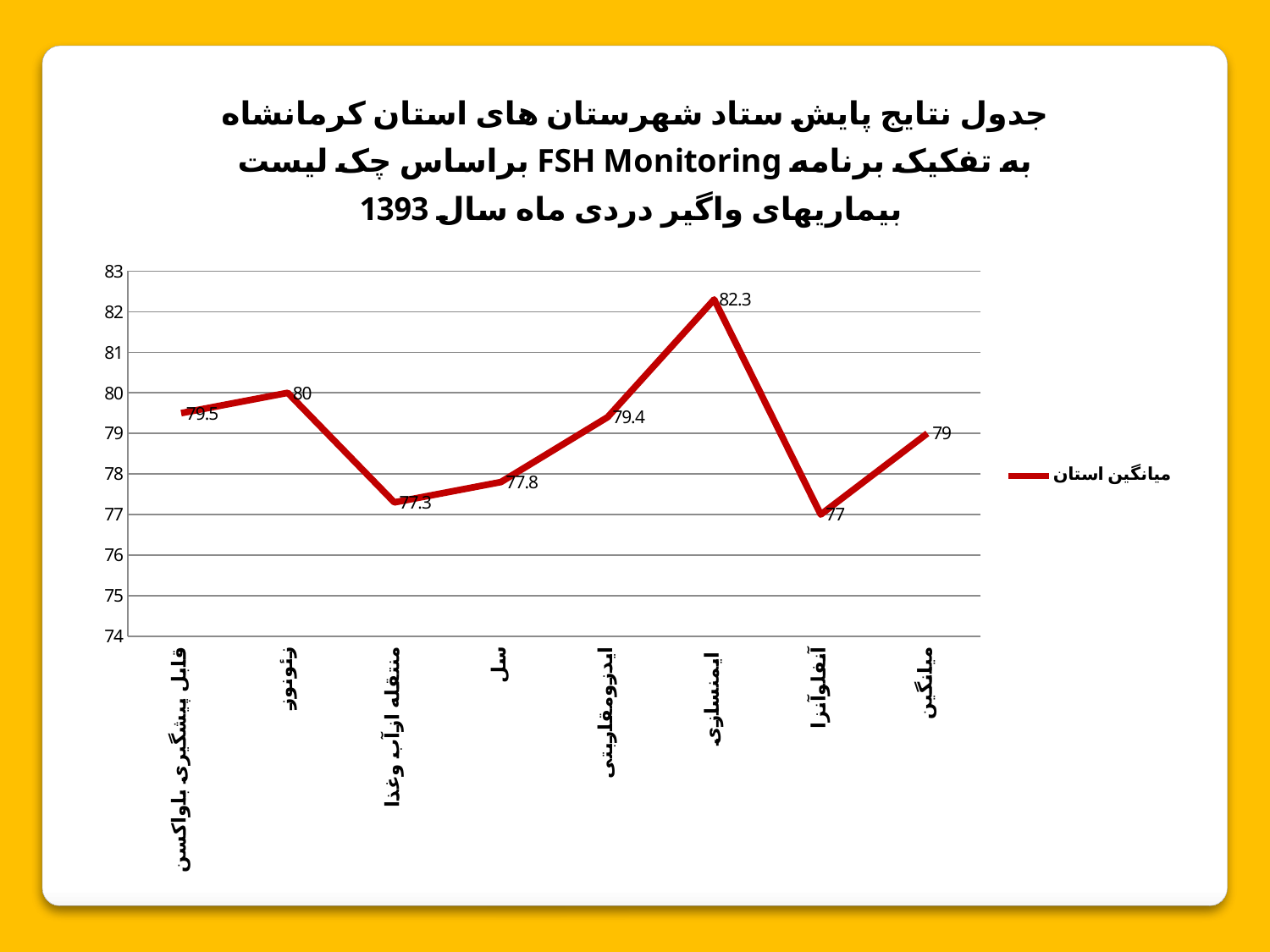
What is the value for زئونوز? 80 What is the legend entry for the plotted series? میانگین استان What is the value for ایمنسازی? 82.3 Which category has the highest value? ایمنسازی What is the difference between the values for ایمنسازی and آنفلوآنزا? 5.3 What kind of chart is shown on the slide? line chart Is the value for منتقله از آب و غذا greater or less than 78? less How many categories are plotted on the x axis? 8 What is the value for آنفلوآنزا? 77 Which category has the lowest value? آنفلوآنزا What is the value for میانگین? 79 Which is larger, the value for زئونوز or the value for سل? زئونوز